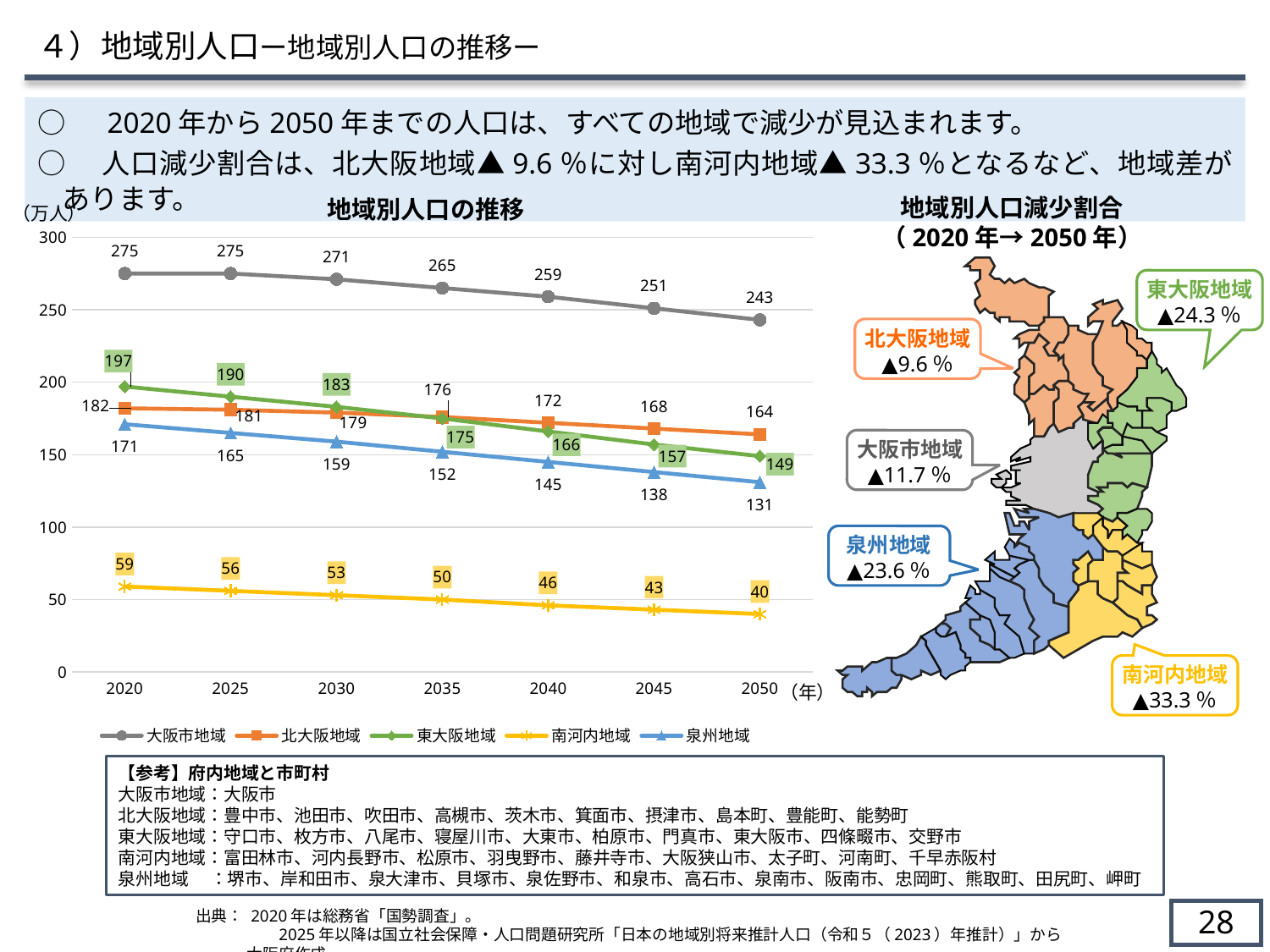
「地域別人口の推移」のグラフで、2020年の大阪市地域の人口は何万人ですか？ 275 「地域別人口の推移」のグラフで、2050年の北大阪地域と東大阪地域では、どちらの人口が多いですか？ 北大阪地域 「地域別人口の推移」のグラフは、どのような種類のグラフですか？ 折れ線グラフ 「地域別人口の推移」のグラフで、泉州地域の人口は2020年から2050年にかけて増加していますか、減少していますか？ 減少 「地域別人口の推移」のグラフで、2040年の泉州地域の人口は何万人ですか？ 145 「地域別人口の推移」のグラフで、2050年に人口が最も多い地域はどこですか？ 大阪市地域 「地域別人口の推移」のグラフで、2020年の東大阪地域の人口は200万人より多いですか、少ないですか？ 少ない 「地域別人口の推移」のグラフの凡例には、いくつの系列がありますか？ 5 「地域別人口の推移」のグラフで、大阪市地域の2020年と2050年の人口の差は何万人ですか？ 32 「地域別人口の推移」のグラフで、2050年の南河内地域の人口は何万人ですか？ 40 「地域別人口の推移」のグラフで、2020年に人口が最も少ない地域はどこですか？ 南河内地域 「地域別人口の推移」のグラフで、2035年の東大阪地域の人口は何万人ですか？ 175